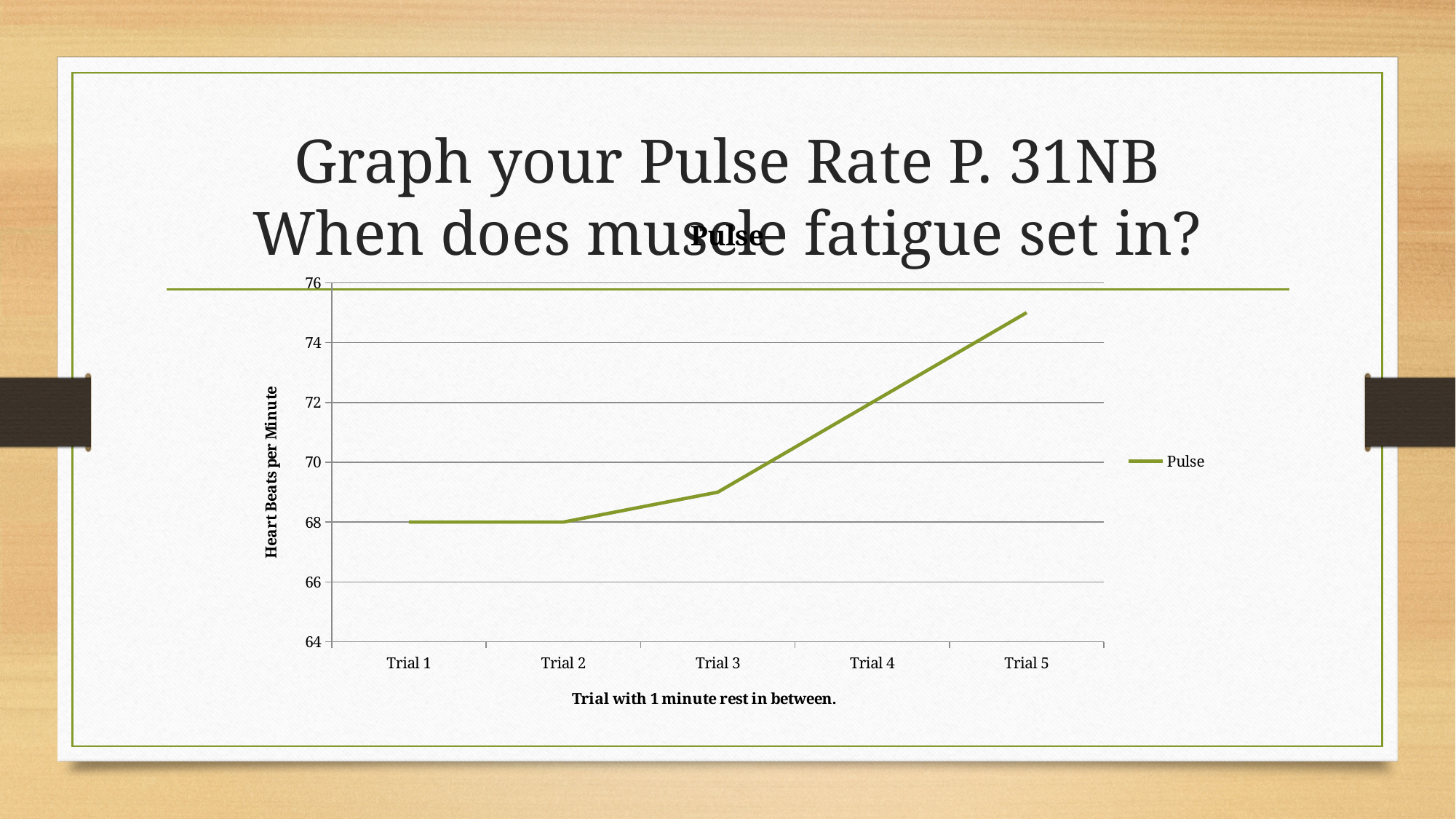
How many series does the legend list? 1 Is the value for Trial 3 greater or less than 70? less What type of chart is shown on the slide? line chart What is the difference between the pulse values for Trial 4 and Trial 1? 4 What is the pulse value for Trial 2? 68 Do the pulse values rise or fall from Trial 1 to Trial 5? rise Is the value for Trial 5 greater or less than 74? greater What is the pulse value for Trial 4? 72 Which has a larger pulse value, Trial 2 or Trial 4? Trial 4 Which trial has the highest pulse value? Trial 5 What is the pulse value for Trial 1? 68 How many trials are plotted on the x axis? 5